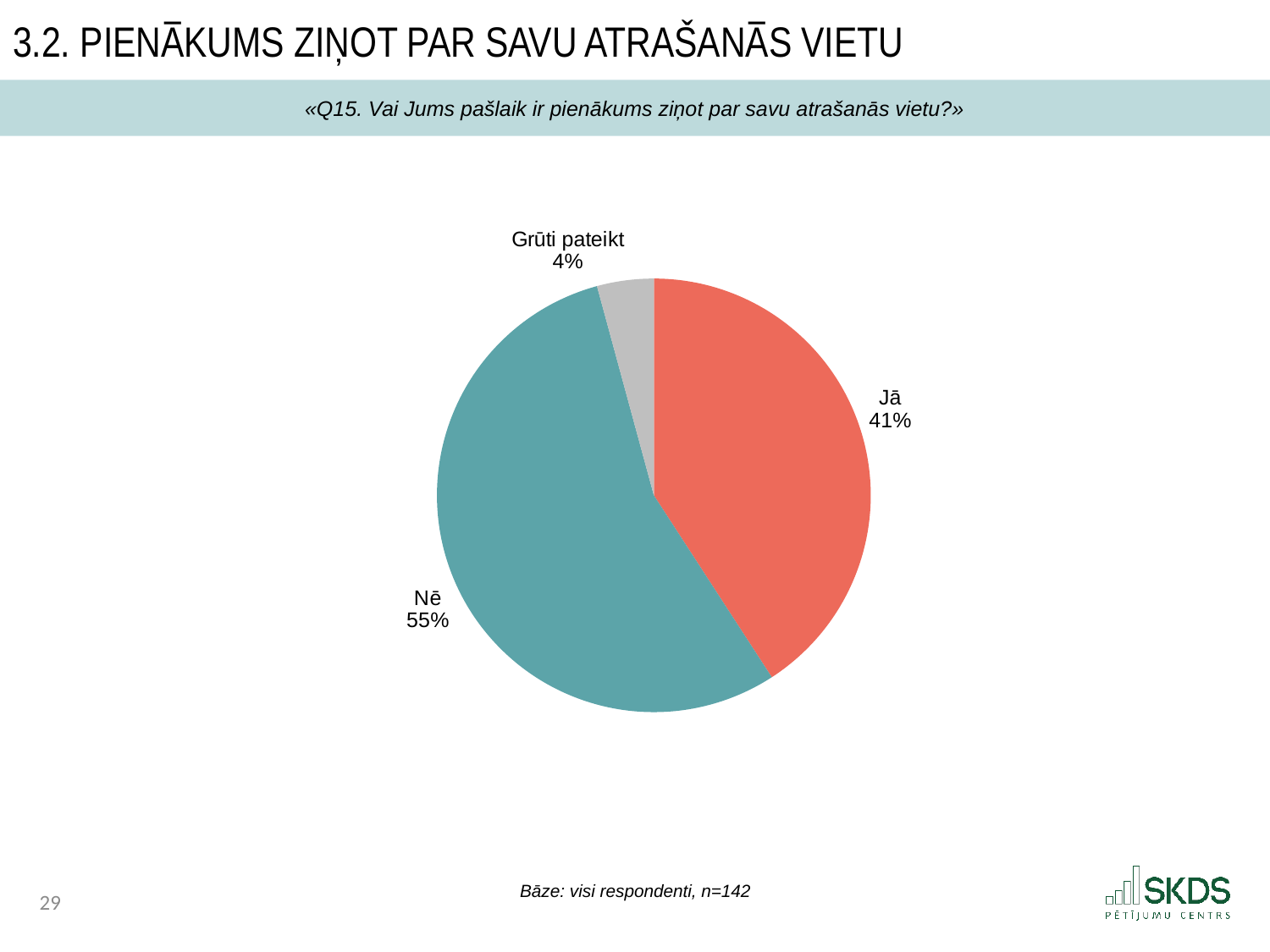
What percentage of respondents answered "Grūti pateikt"? 4% What colour is the "Nē" slice? teal What type of chart is shown on the slide? pie chart How many slices does the pie chart have? 3 Which response has the largest share of the pie? Nē Which is larger, the share for "Jā" or the share for "Nē"? Nē What is the difference in percentage points between "Nē" and "Jā"? 14 What percentage of respondents answered "Nē"? 55% What is the combined share of "Jā" and "Grūti pateikt"? 45% What is the base (number of respondents) stated below the chart? n=142 What percentage of respondents answered "Jā"? 41% Which response has the smallest share of the pie? Grūti pateikt